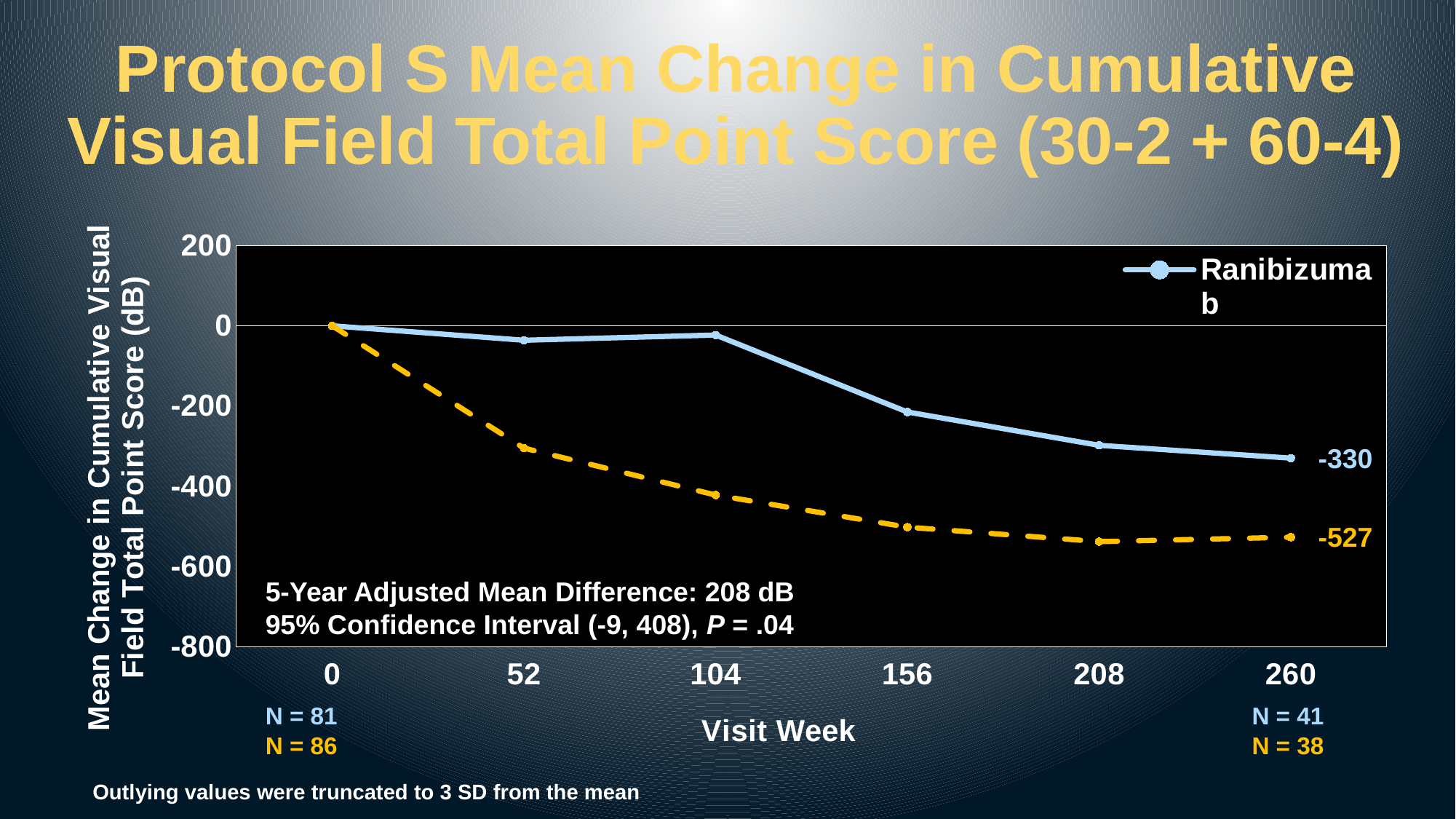
What is the difference between the Ranibizumab value (-330) and the dashed yellow line value (-527) at week 260? 197 Is the value of the Ranibizumab line at week 208 greater or less than -200? less What kind of chart is shown on the slide? line chart What is the value of the dashed yellow line at visit week 260? -527 How many visit weeks are labelled on the x axis? 6 What is the value of the Ranibizumab line at visit week 260? -330 Is the value of the dashed yellow line at week 52 greater or less than -200? less At visit week 260, which line has the higher value, the Ranibizumab line or the dashed yellow line? Ranibizumab At which visit week is the Ranibizumab line at its lowest value? 260 How many entries does the chart legend list? 1 What is the title of the x axis? Visit Week Does the Ranibizumab line rise or fall from week 0 to week 260? fall